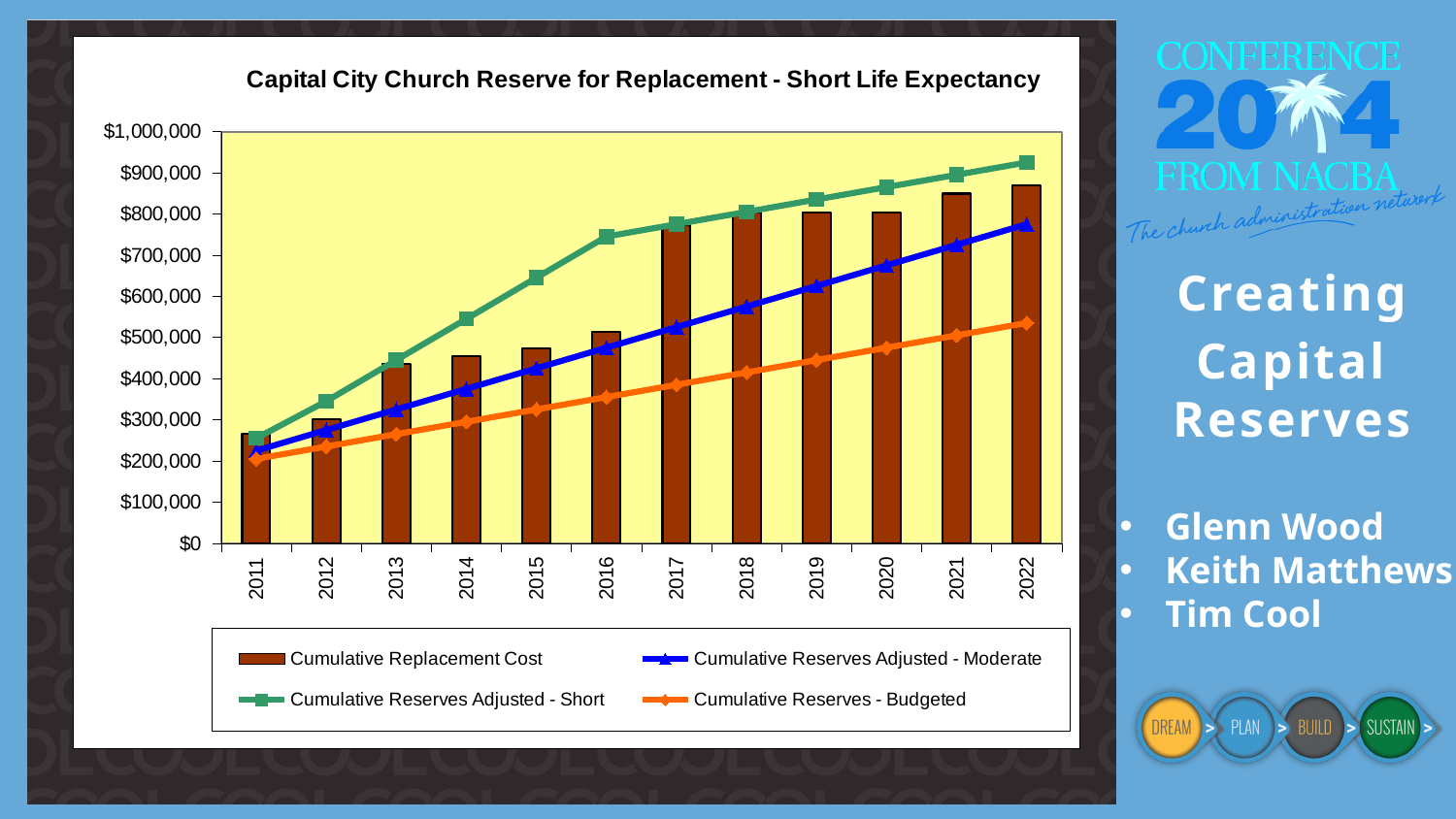
In 2022, which is larger: Cumulative Reserves Adjusted - Short or Cumulative Replacement Cost? Cumulative Reserves Adjusted - Short Is the Cumulative Reserves Adjusted - Moderate value for 2022 greater or less than $800,000? less What kind of chart is used to plot the Cumulative Replacement Cost series? bar chart Does the Cumulative Replacement Cost rise or fall from 2011 to 2022? rise How many series does the chart's legend list? 4 What is the title of the chart? Capital City Church Reserve for Replacement - Short Life Expectancy In which year is the Cumulative Replacement Cost highest? 2022 Is the Cumulative Replacement Cost for 2022 greater or less than $800,000? greater What kind of chart is used to plot the Cumulative Reserves - Budgeted series? line chart How many years are shown along the x axis of the chart? 12 In 2016, which is larger: Cumulative Reserves Adjusted - Short or Cumulative Replacement Cost? Cumulative Reserves Adjusted - Short Is the Cumulative Reserves Adjusted - Short value for 2022 greater or less than $900,000? greater